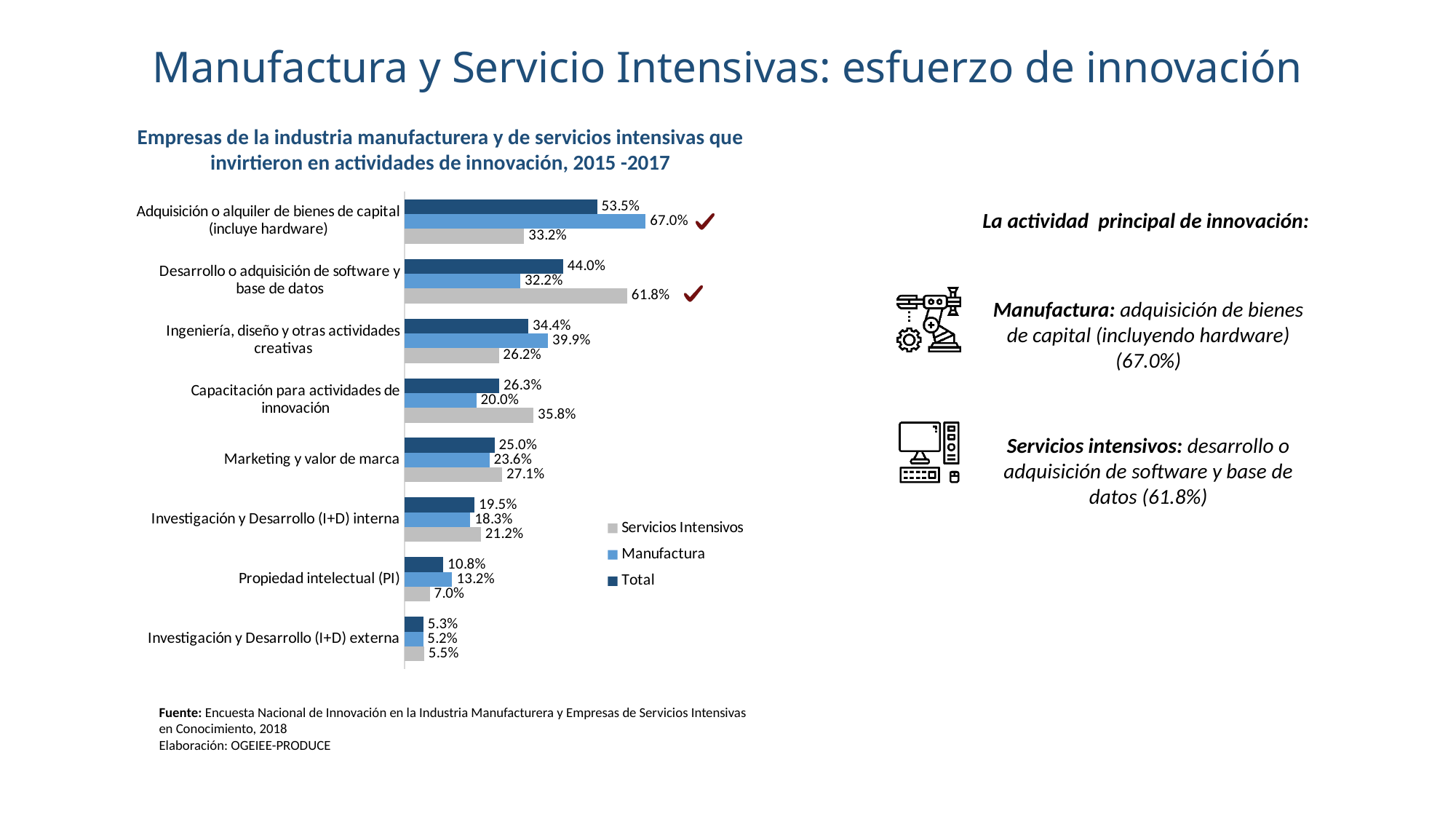
What kind of chart is shown on the slide? Bar chart How many categories are shown on the chart? 8 Which category has the lowest Manufactura value? Investigación y Desarrollo (I+D) externa What is the Manufactura value for 'Adquisición o alquiler de bienes de capital (incluye hardware)'? 67.0% What is the Servicios Intensivos value for 'Propiedad intelectual (PI)'? 7.0% What is the Total value for 'Capacitación para actividades de innovación'? 26.3% Which series is shown in gray in the legend? Servicios Intensivos Which category has the highest Servicios Intensivos value? Desarrollo o adquisición de software y base de datos How many series does the legend list? 3 What is the Servicios Intensivos value for 'Desarrollo o adquisición de software y base de datos'? 61.8% For 'Ingeniería, diseño y otras actividades creativas', which is larger: the Manufactura value or the Servicios Intensivos value? Manufactura What is the difference between the Manufactura and Servicios Intensivos values for 'Adquisición o alquiler de bienes de capital (incluye hardware)'? 33.8%